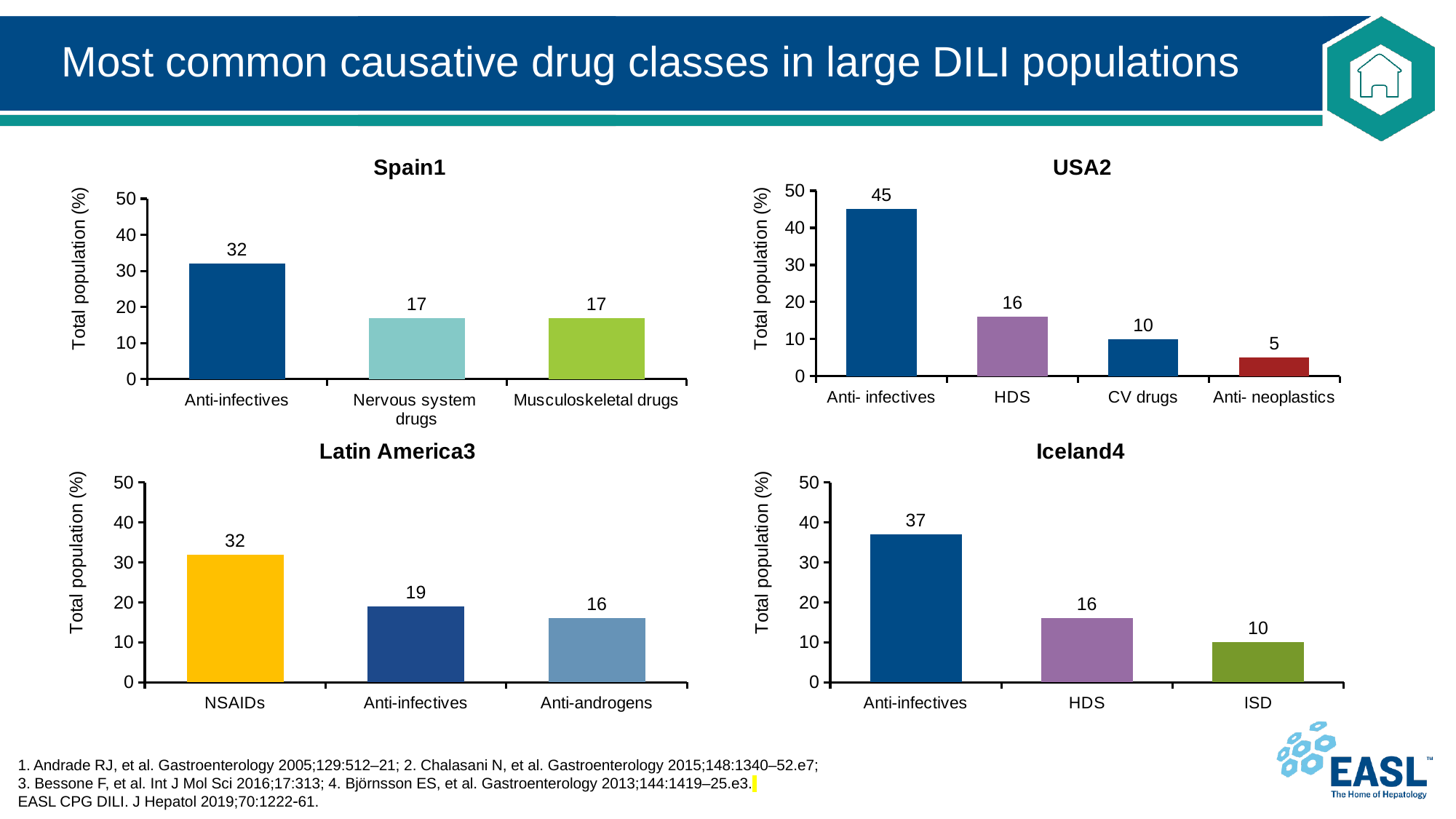
In the Iceland chart, what is the difference between Anti-infectives and HDS? 21 In the Latin America chart, which drug class has the highest value? NSAIDs In the Iceland chart, what is the value for ISD? 10 In the USA chart, which drug class has the lowest value? Anti- neoplastics In the Latin America chart, what is the value for Anti-androgens? 16 In the USA chart, what is the value for HDS? 16 In the Latin America chart, which is larger: Anti-infectives or Anti-androgens? Anti-infectives What type of chart is the Spain chart? Bar chart In the USA chart, what is the difference between Anti- infectives and CV drugs? 35 How many drug classes are shown in the USA chart? 4 What is the y-axis label on the Iceland chart? Total population (%) In the Spain chart, what is the value for Anti-infectives? 32